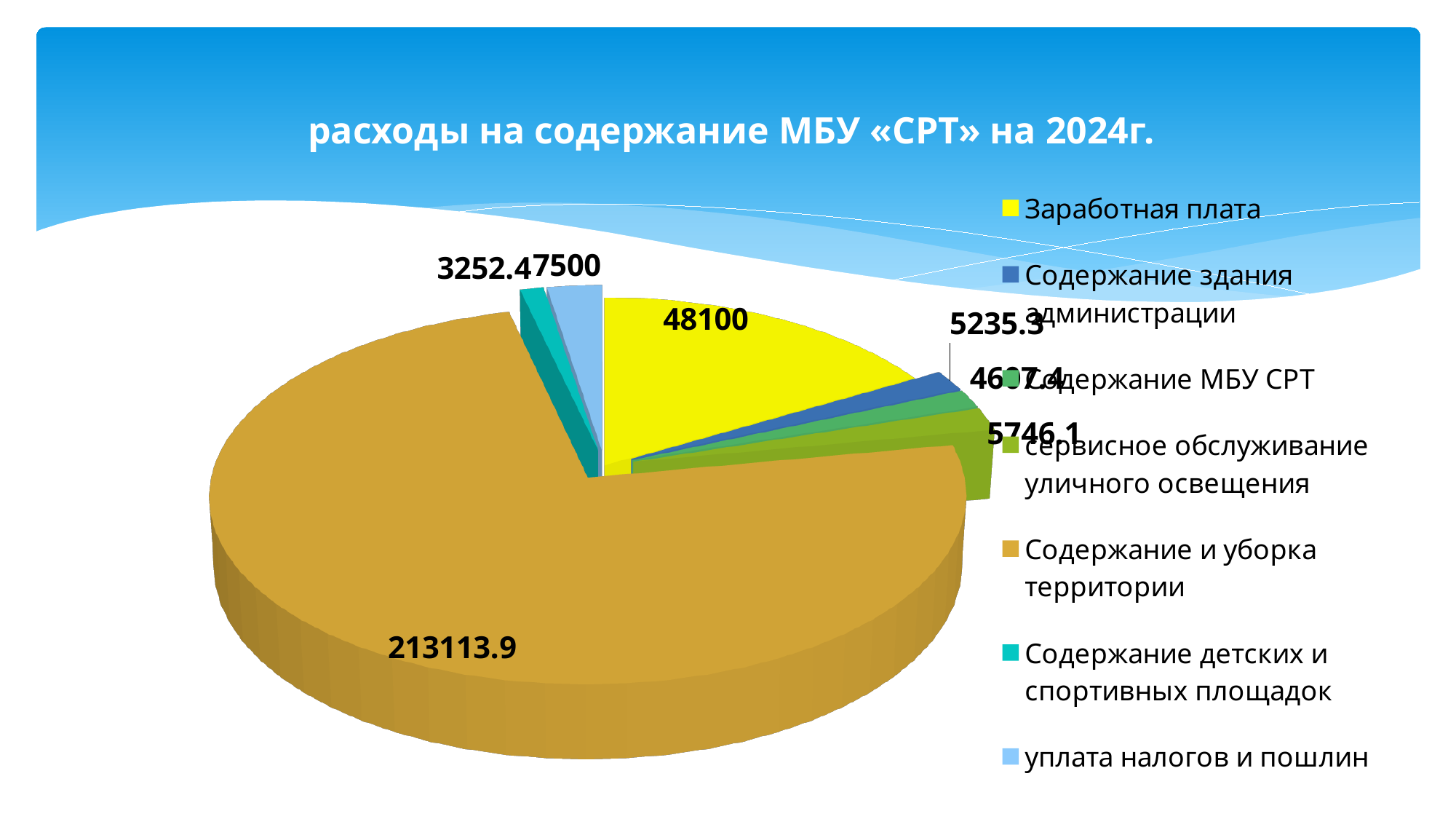
What is the value for Содержание и уборка территории? 213113.9 How many categories does the legend list? 7 What is the value for Заработная плата? 48100 What type of chart is shown on the slide? pie chart What is the difference between сервисное обслуживание уличного освещения and Содержание здания администрации? 510.8 Which is larger, Заработная плата or Содержание и уборка территории? Содержание и уборка территории What is the title of the chart? расходы на содержание МБУ «СРТ» на 2024г. Which category has the largest slice of the pie? Содержание и уборка территории What is the value for Содержание здания администрации? 5235.3 What colour is the slice for Заработная плата? yellow What is the difference between Содержание и уборка территории and Заработная плата? 165013.9 What is the value for сервисное обслуживание уличного освещения? 5746.1